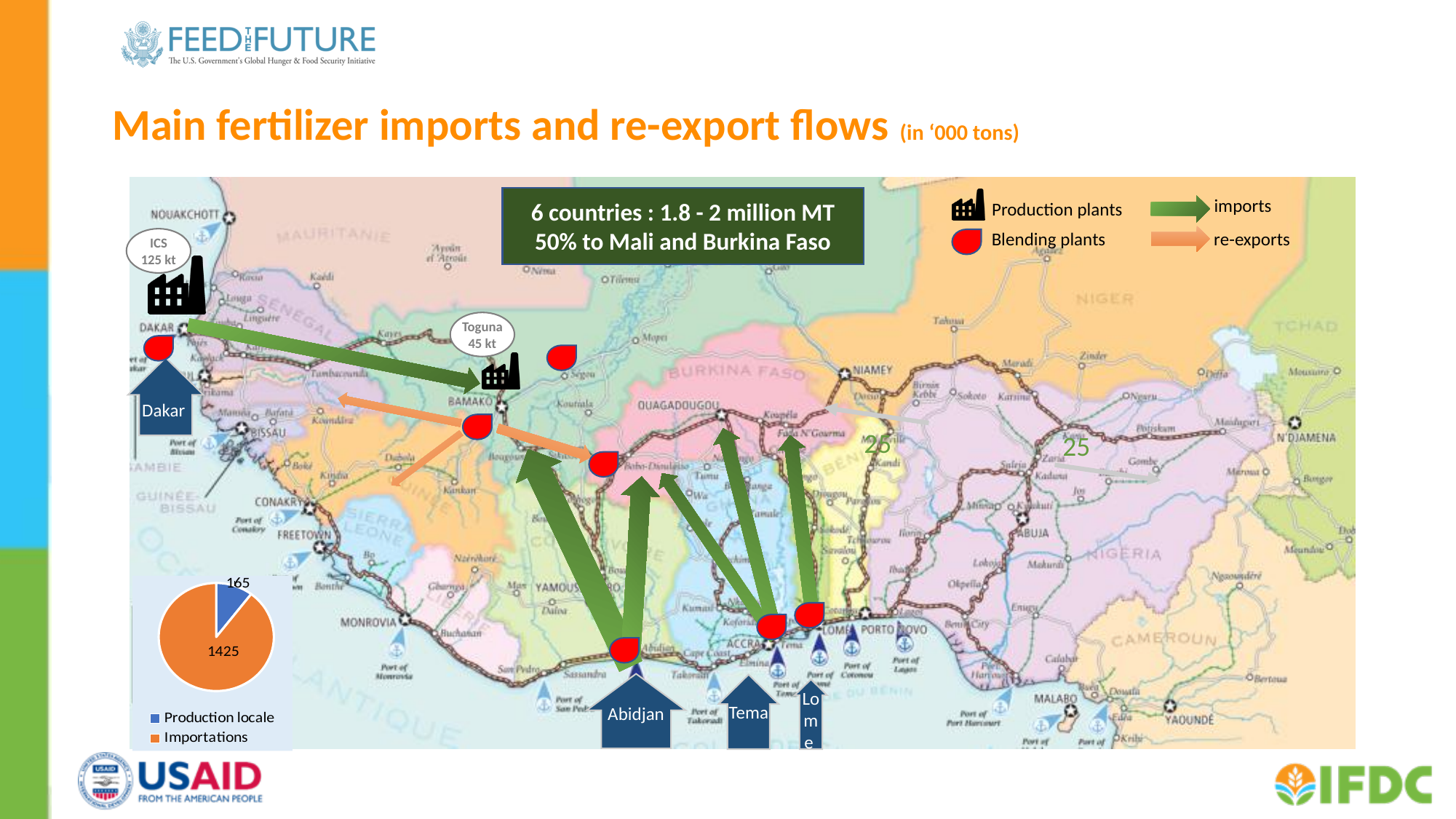
Which category in the pie chart has the largest value? Importations What is the total of the two values shown in the pie chart? 1590 How many slices does the pie chart have? 2 In the pie chart, what is the value for Importations? 1425 What kind of chart is shown in the bottom-left corner of the slide? pie chart What share of the pie chart does Importations represent? 89.6% What colour is the Importations slice in the pie chart? orange In the pie chart, which is larger: Production locale or Importations? Importations Which category in the pie chart has the smallest value? Production locale How many entries does the pie chart's legend list? 2 In the pie chart, what is the value for Production locale? 165 In the pie chart, what is the difference between Importations and Production locale? 1260